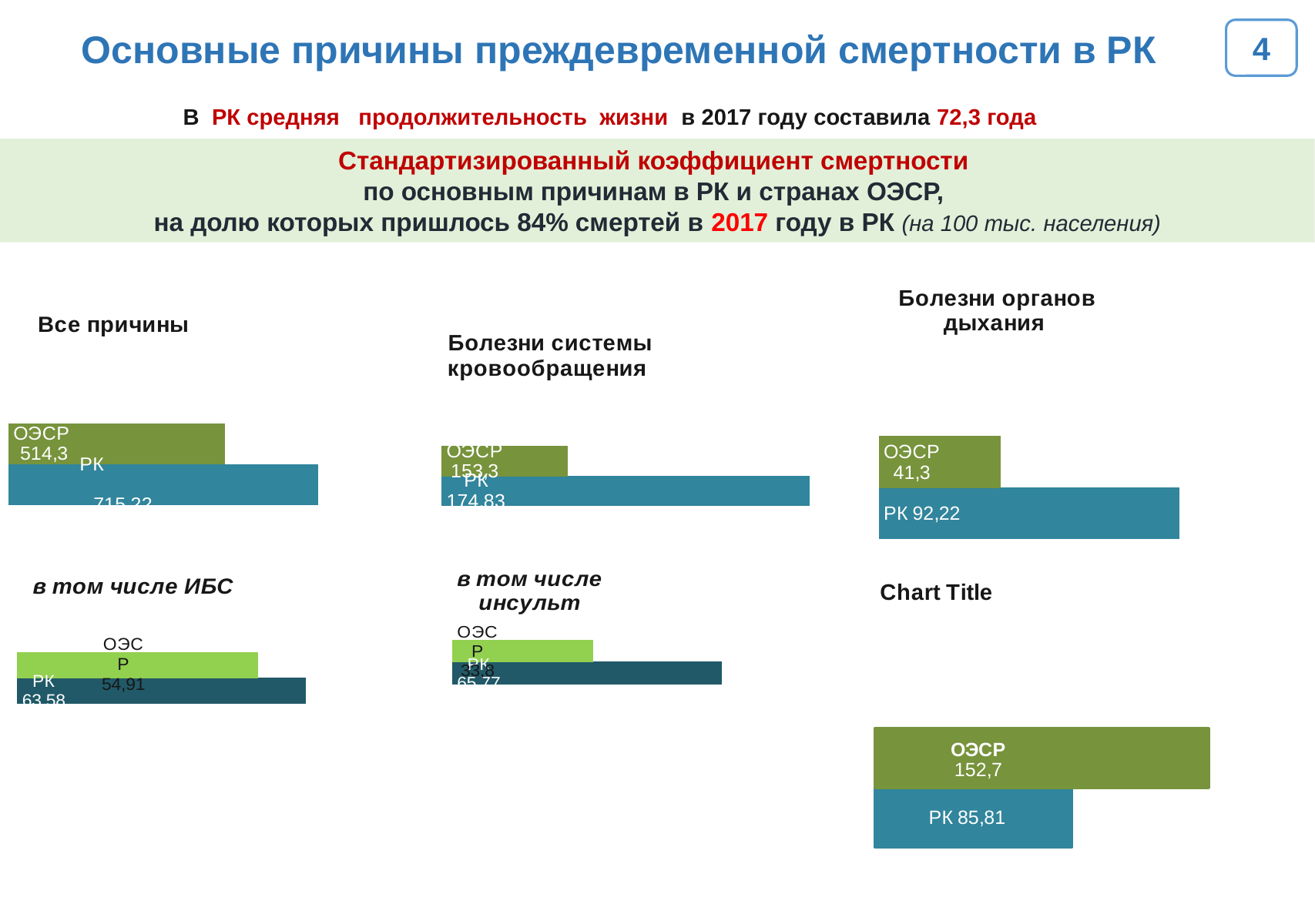
In the chart titled 'Chart Title' at the bottom right, which is larger, ОЭСР or РК? ОЭСР What kind of chart is the 'Все причины' chart? Bar chart In the 'Болезни органов дыхания' chart, what is the value for РК? 92,22 In the 'в том числе ИБС' chart, what is the value for ОЭСР? 54,91 In the 'Болезни органов дыхания' chart, what is the value for ОЭСР? 41,3 In the 'Все причины' chart, what is the value for РК? 715,22 In the 'в том числе инсульт' chart, which is larger, ОЭСР or РК? РК In the 'Болезни системы кровообращения' chart, what is the value for ОЭСР? 153,3 How many bars does the 'Болезни системы кровообращения' chart have? 2 In the chart titled 'Chart Title' at the bottom right, what is the value for РК? 85,81 In the 'Все причины' chart, what is the value for ОЭСР? 514,3 In the 'Болезни органов дыхания' chart, what is the difference between the РК and ОЭСР values? 50,92